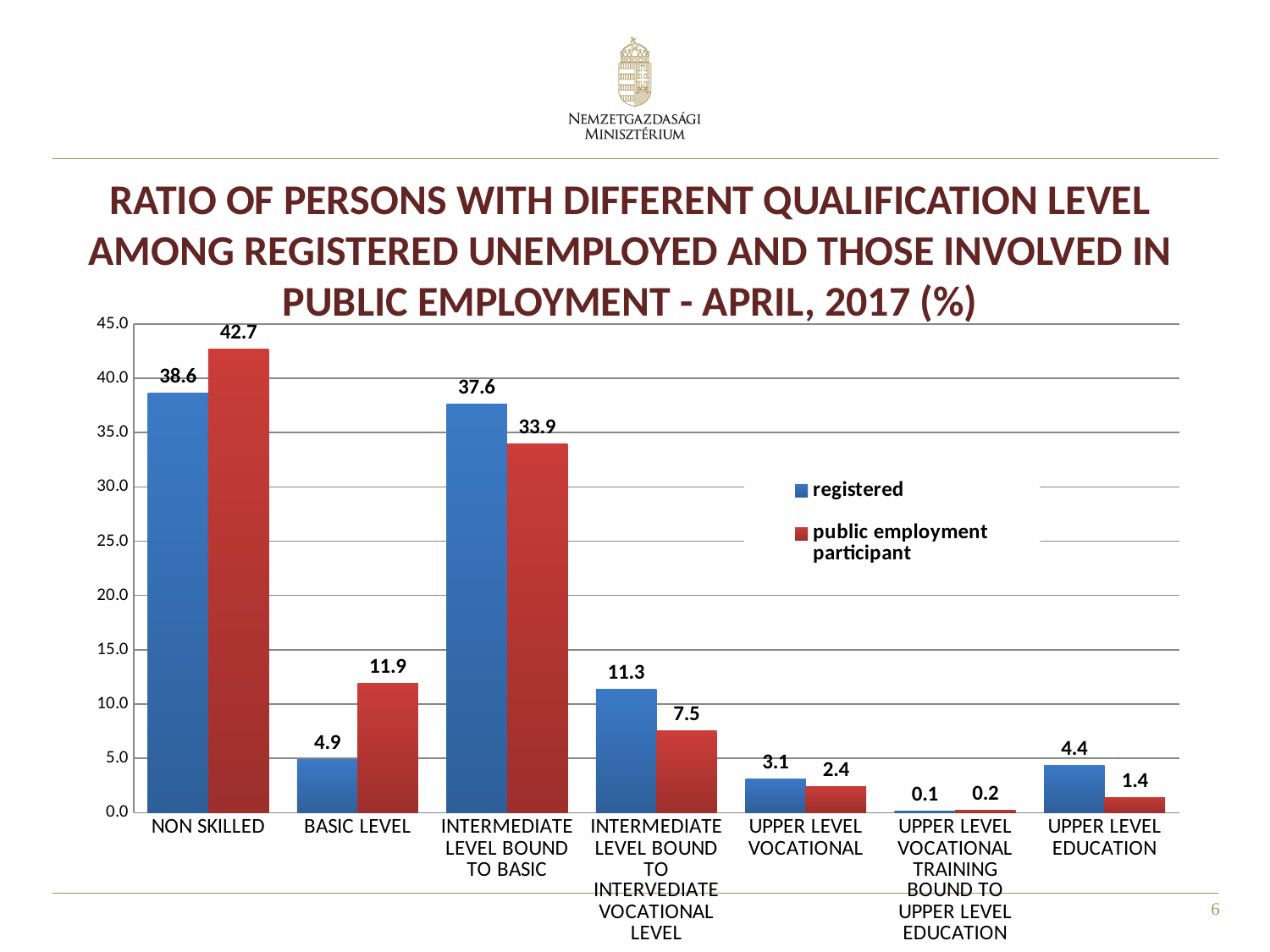
What is the value for registered in the UPPER LEVEL EDUCATION category? 4.4 Which category has the highest value for public employment participant? NON SKILLED Which category has the lowest value for registered? UPPER LEVEL VOCATIONAL TRAINING BOUND TO UPPER LEVEL EDUCATION Is the value for registered in the INTERMEDIATE LEVEL BOUND TO INTERVEDIATE VOCATIONAL LEVEL category greater or less than 10.0? greater What is the difference between the public employment participant and registered values in the NON SKILLED category? 4.1 What kind of chart is shown on the slide? bar chart In the INTERMEDIATE LEVEL BOUND TO BASIC category, which series has the larger value, registered or public employment participant? registered How many series does the legend list? 2 What colour are the bars for the public employment participant series? red What is the value for public employment participant in the BASIC LEVEL category? 11.9 How many categories are shown on the x axis? 7 What is the value for registered in the NON SKILLED category? 38.6